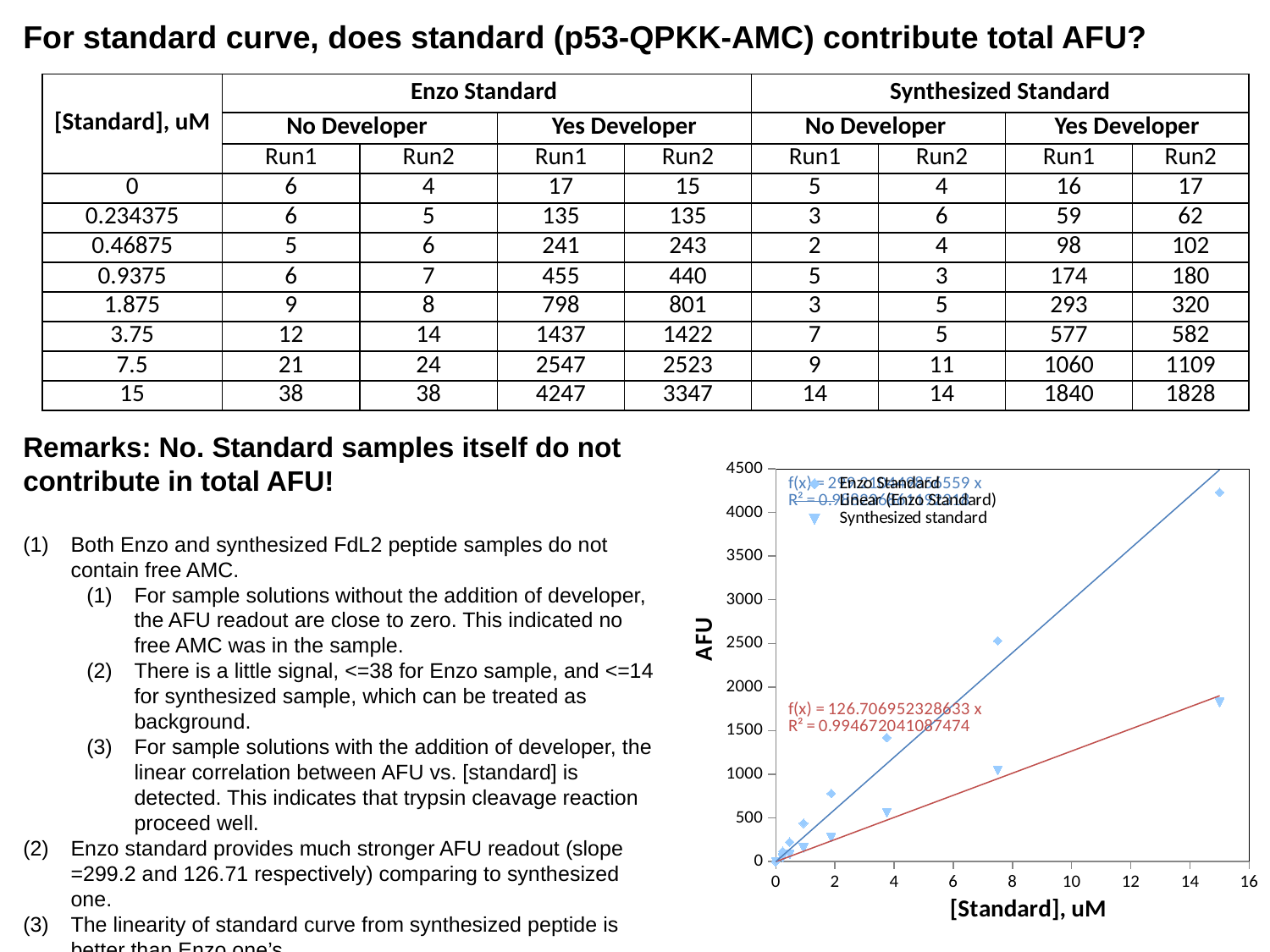
Is the Synthesized standard AFU value at [Standard] = 15 uM greater or less than 2000? less What is the title of the x axis of the chart? [Standard], uM What kind of chart is shown on the slide? scatter chart What is the slope shown in the trendline equation for the Synthesized standard series? 126.706952328633 What is the R² value shown for the Synthesized standard trendline? 0.994672041087474 What is the title of the y axis of the chart? AFU At [Standard] = 15 uM, which series has the higher AFU value, Enzo Standard or Synthesized standard? Enzo Standard Is the Enzo Standard AFU value at [Standard] = 7.5 uM greater or less than 2000? greater Is the Enzo Standard AFU value at [Standard] = 15 uM greater or less than 4000? greater Do the Enzo Standard AFU values rise or fall as [Standard] increases along the x axis? rise How many entries does the chart legend list? 3